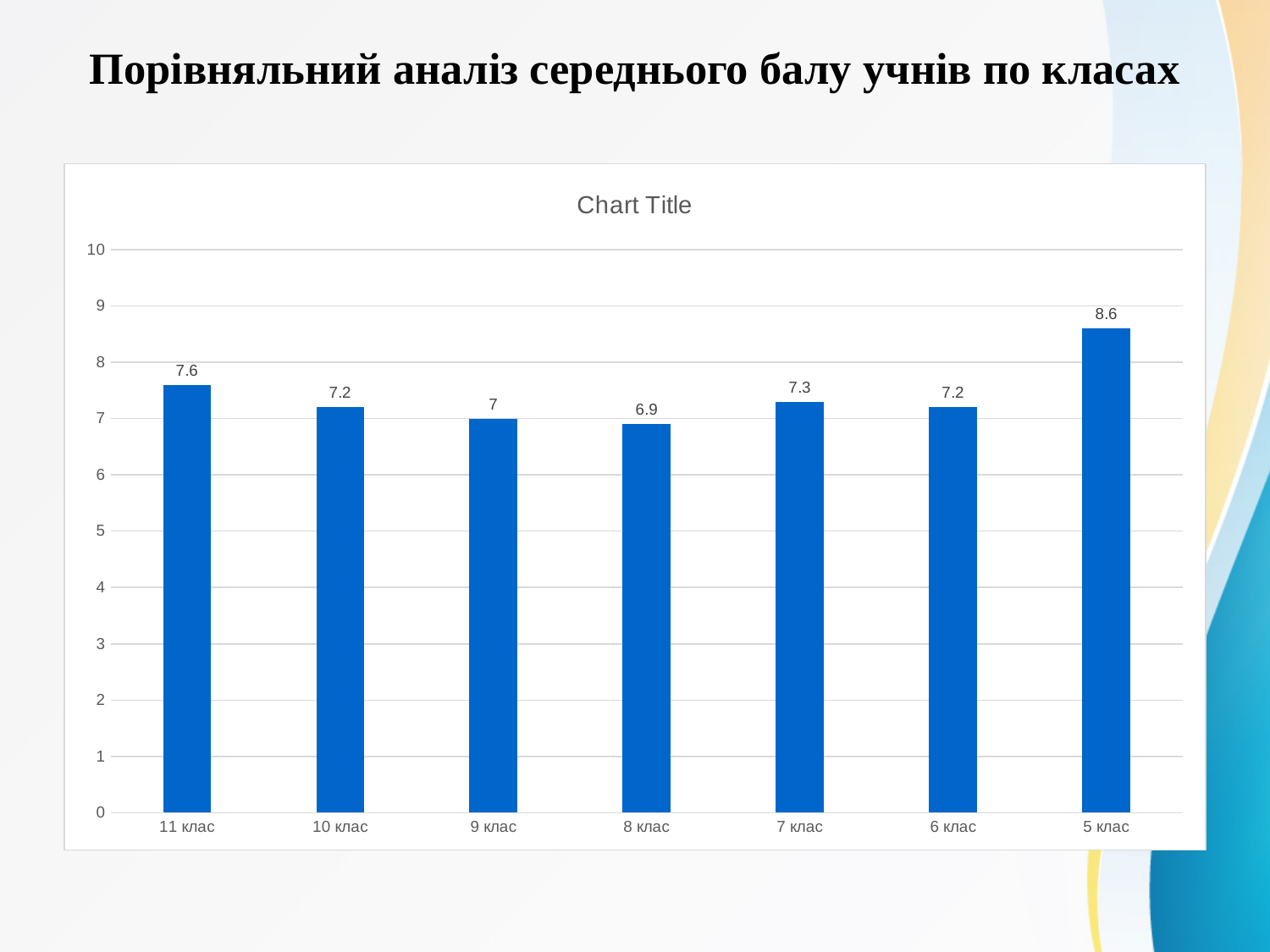
What is the title shown inside the chart area? Chart Title Is the value for 9 клас greater or less than 8? less What is the value for 8 клас? 6.9 What kind of chart is shown on the slide? bar chart What is the value for 7 клас? 7.3 Which is larger, the value for 11 клас or the value for 10 клас? 11 клас Which class has the lowest value? 8 клас What is the value for 5 клас? 8.6 Which class has the highest value? 5 клас How many classes are shown on the chart? 7 What is the value for 11 клас? 7.6 What is the difference between the values for 5 клас and 8 клас? 1.7